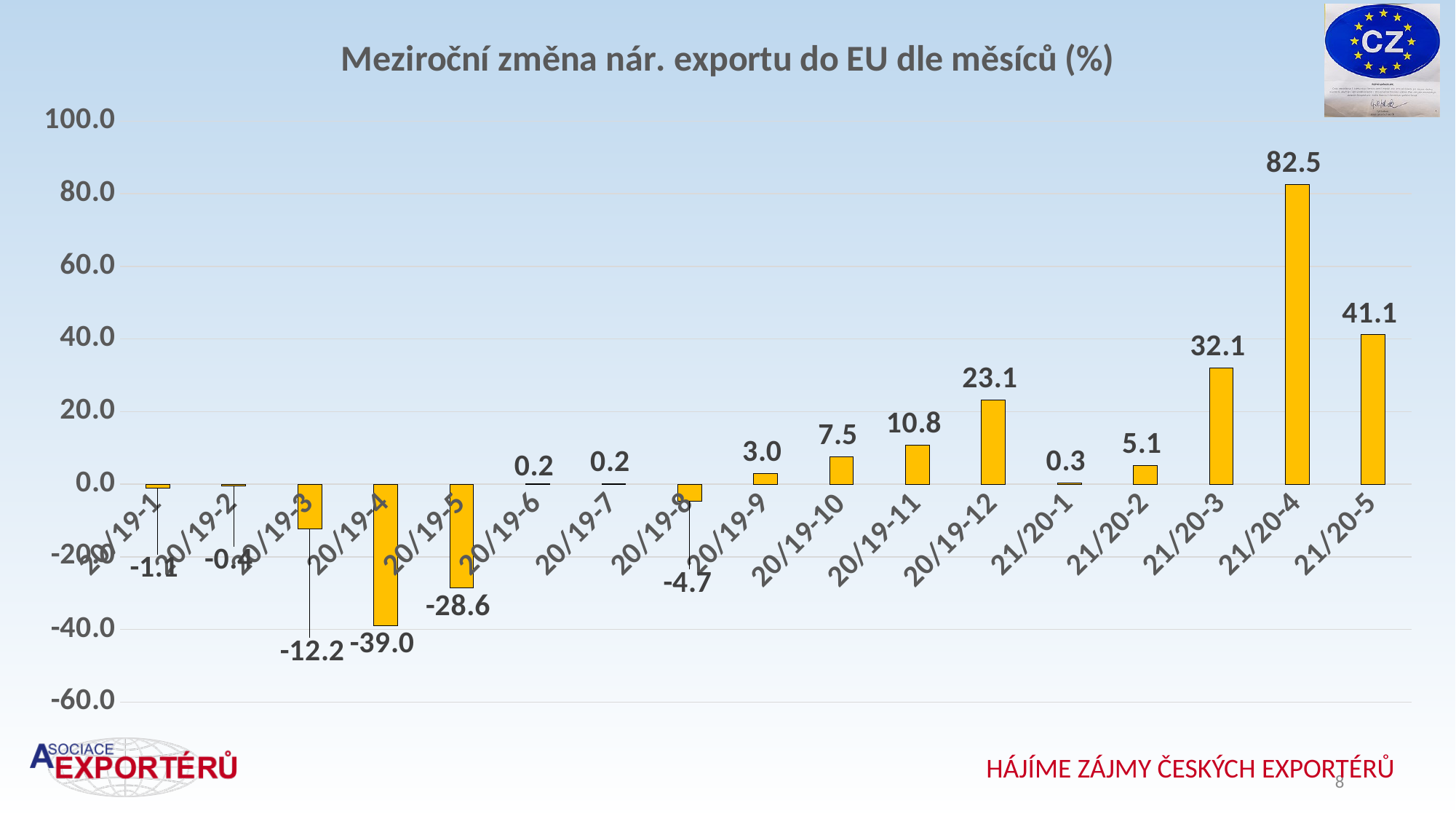
What is the difference between the values for 21/20-4 and 21/20-5? 41.4 What is the value for 20/19-8? -4.7 What kind of chart is shown on the slide? bar chart Is the value for 20/19-5 greater or less than -20.0? less Which month has the highest value? 21/20-4 Which month has the lowest value? 20/19-4 What is the value for 20/19-4? -39.0 What is the title of the chart? Meziroční změna nár. exportu do EU dle měsíců (%) What is the value for 20/19-12? 23.1 What is the value for 21/20-4? 82.5 Which is larger, the value for 21/20-3 or the value for 20/19-12? 21/20-3 How many months are shown on the x axis? 17